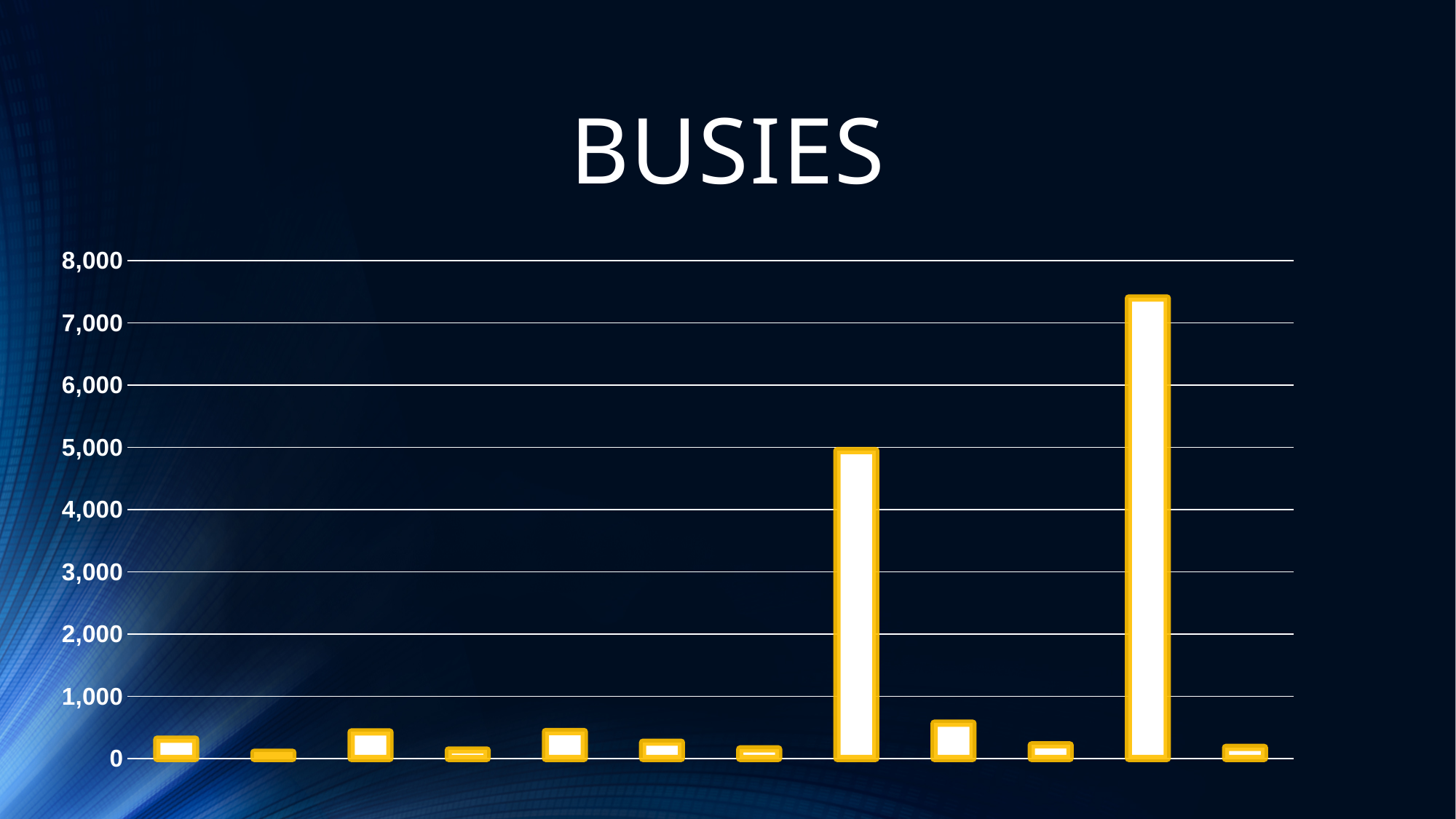
Which is larger, the eighth bar from the left or the eleventh bar from the left? the eleventh bar Is the value of the eighth bar from the left greater or less than 4,000? greater How many bars are plotted in the chart? 12 What is the highest value shown on the vertical axis? 8,000 Which bar is the tallest in the chart? the eleventh bar (second from the right) Is the value of the last bar on the right greater or less than 1,000? less Is the value of the tallest bar greater or less than 7,000? greater What kind of chart is shown on the slide? bar chart What is the title of the chart? BUSIES